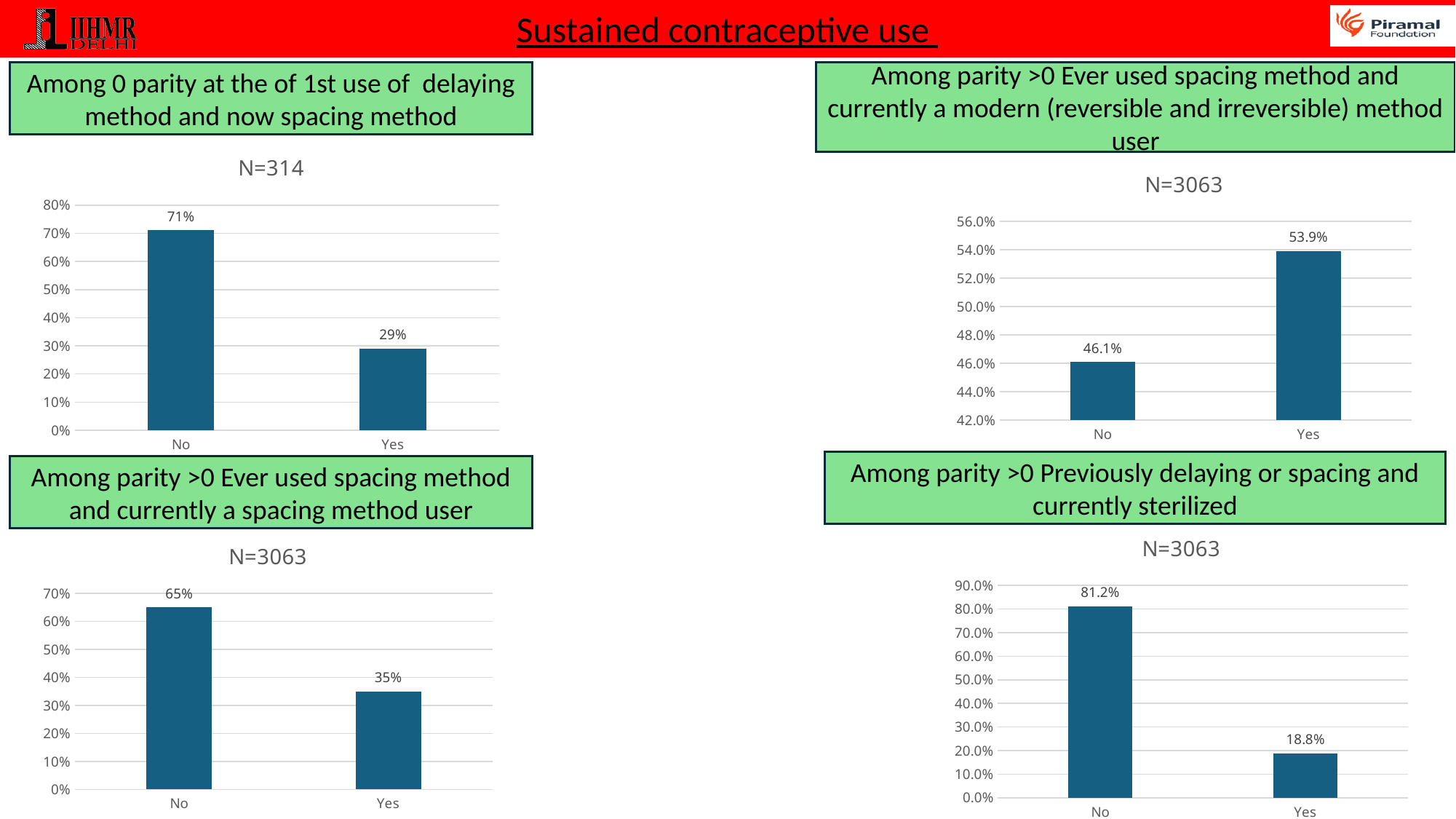
In the top-right chart (N=3063, modern method user), which category is lowest? No In the bottom-right chart (currently sterilized), which category is highest? No In the top-left chart (N=314), what is the value for No? 71% In the top-right chart (N=3063, modern method user), what is the value for No? 46.1% In the top-right chart (N=3063, modern method user), what is the value for Yes? 53.9% In the top-right chart (N=3063, modern method user), is the value for Yes larger or smaller than the value for No? larger In the bottom-left chart (currently a spacing method user), what is the difference between No and Yes? 30% In the top-left chart (N=314), what is the value for Yes? 29% In the bottom-left chart (currently a spacing method user), what is the value for No? 65% In the bottom-right chart (currently sterilized), what is the difference between No and Yes? 62.4% What kind of chart is the top-left chart (N=314)? bar chart In the bottom-right chart (currently sterilized), what is the value for Yes? 18.8%